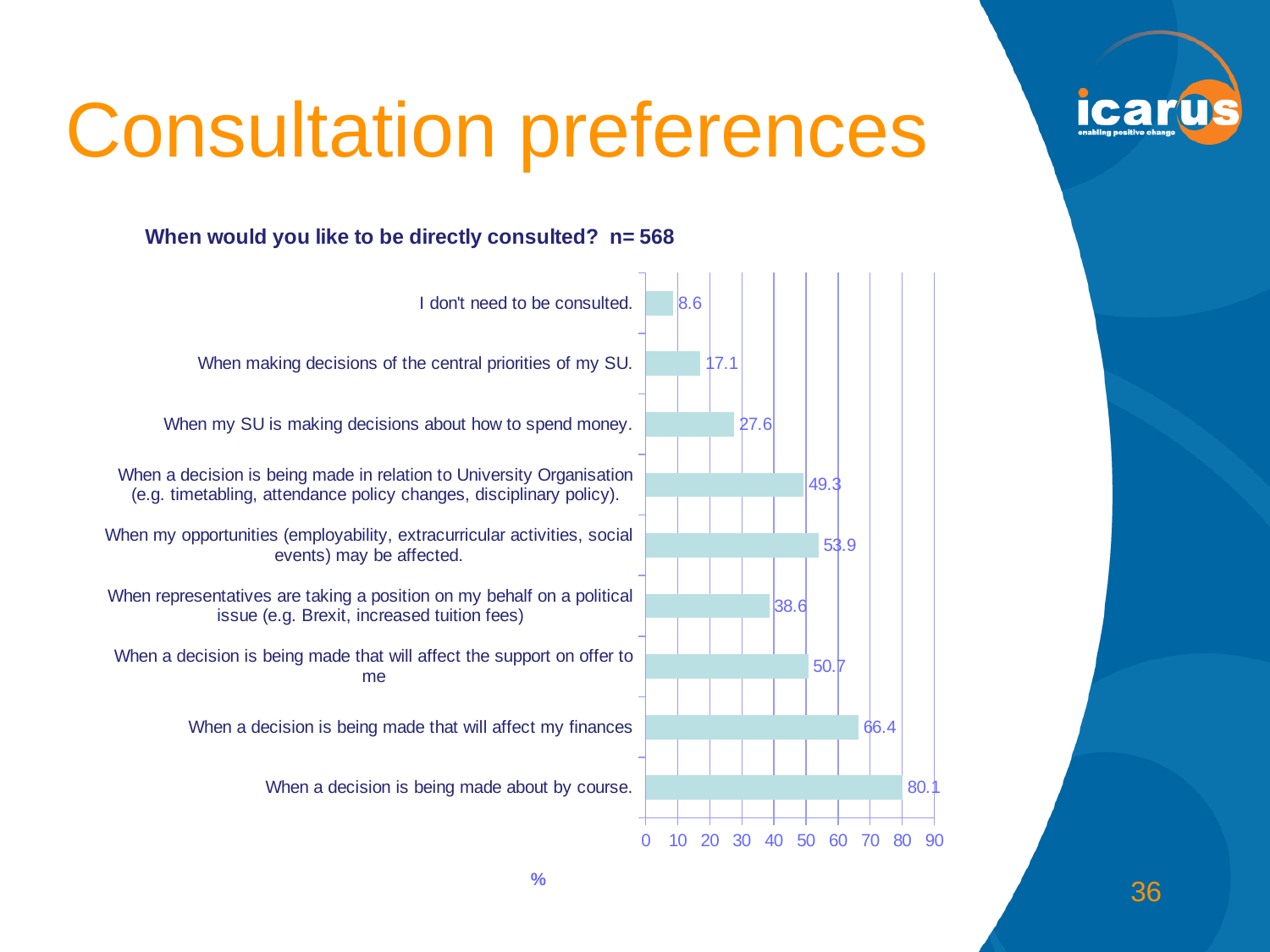
What is the value for "When a decision is being made about by course."? 80.1 What is the sample size (n) stated in the chart heading? 568 What kind of chart is shown on the slide? bar chart What is the value for "I don't need to be consulted."? 8.6 What is the difference between the values for "When a decision is being made about by course." and "When a decision is being made that will affect my finances"? 13.7 What is the value for "When my SU is making decisions about how to spend money."? 27.6 How many categories are shown in the chart? 9 Which category has the highest value? When a decision is being made about by course. What is the value for "When a decision is being made that will affect my finances"? 66.4 Is the value for "When making decisions of the central priorities of my SU." greater or less than 20? less Which is larger: the value for "When my opportunities (employability, extracurricular activities, social events) may be affected." or the value for "When representatives are taking a position on my behalf on a political issue (e.g. Brexit, increased tuition fees)"? When my opportunities (employability, extracurricular activities, social events) may be affected. Which category has the lowest value? I don't need to be consulted.